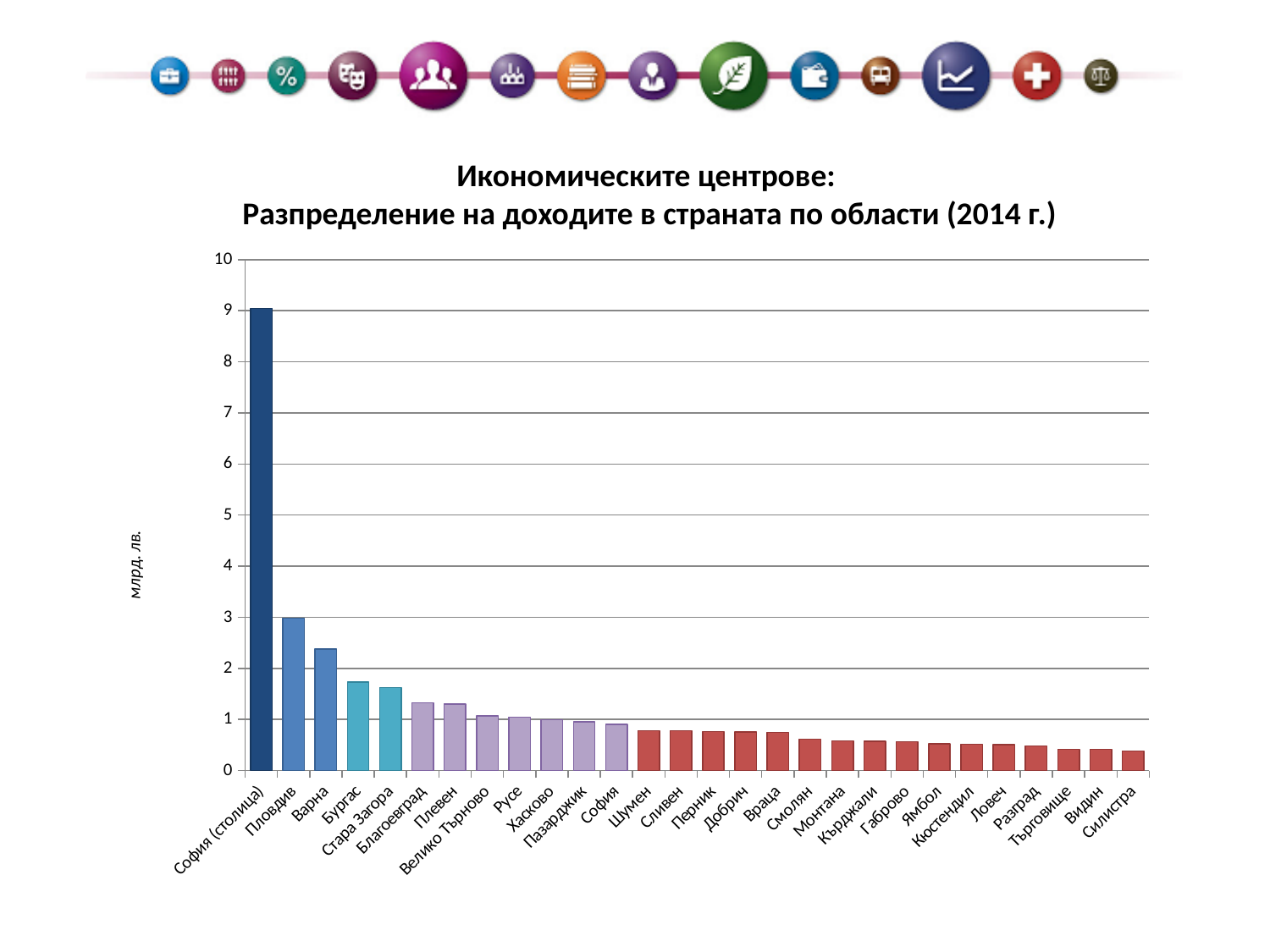
What unit is shown on the vertical axis of the chart? млрд. лв. Is the value for Бургас greater or less than 2? less Is the value for София (столица) greater or less than 8? greater Which област has the highest value in the chart? София (столица) Is the value for Пловдив greater or less than 4? less What kind of chart is shown on the slide? bar chart How many области (categories) are plotted in the chart? 28 Do the values rise or fall moving from left to right along the x axis? fall Which is larger, the value for Пловдив or the value for Варна? Пловдив Which is larger, the value for Стара Загора or the value for Шумен? Стара Загора